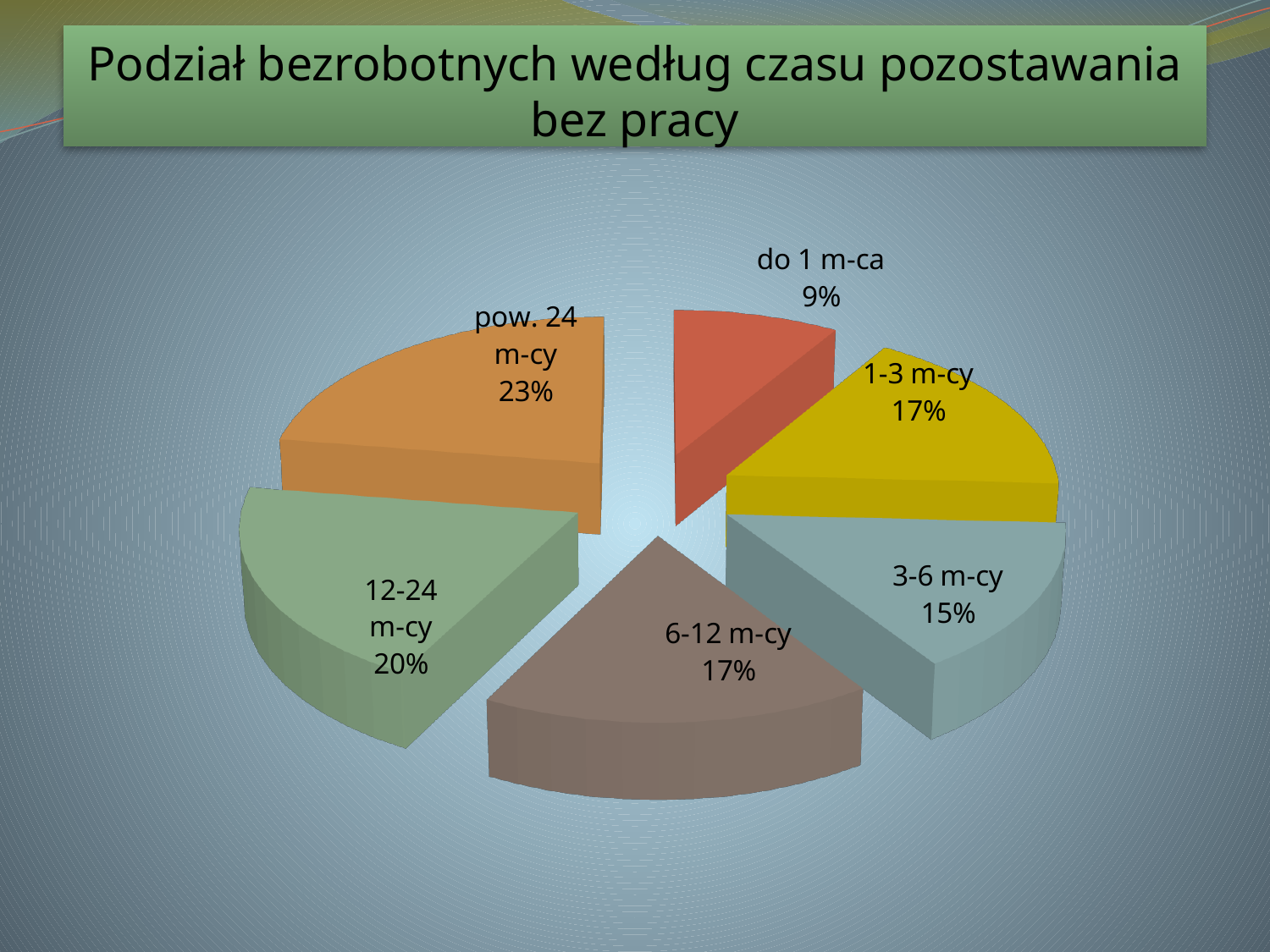
What share is shown for the '12-24 m-cy' slice? 20% Which is larger, the share for '12-24 m-cy' or the share for '3-6 m-cy'? 12-24 m-cy Which category has the largest share of the pie? pow. 24 m-cy What share is shown for the '3-6 m-cy' slice? 15% What is the difference in percentage points between 'pow. 24 m-cy' and 'do 1 m-ca'? 14 What share of the unemployed have been without work for 'do 1 m-ca'? 9% What type of chart is shown on the slide? pie chart Which category has the smallest share of the pie? do 1 m-ca What is the title of the slide? Podział bezrobotnych według czasu pozostawania bez pracy How many slices does the pie chart have? 6 What share is shown for the '1-3 m-cy' slice? 17% What share is shown for the 'pow. 24 m-cy' slice? 23%